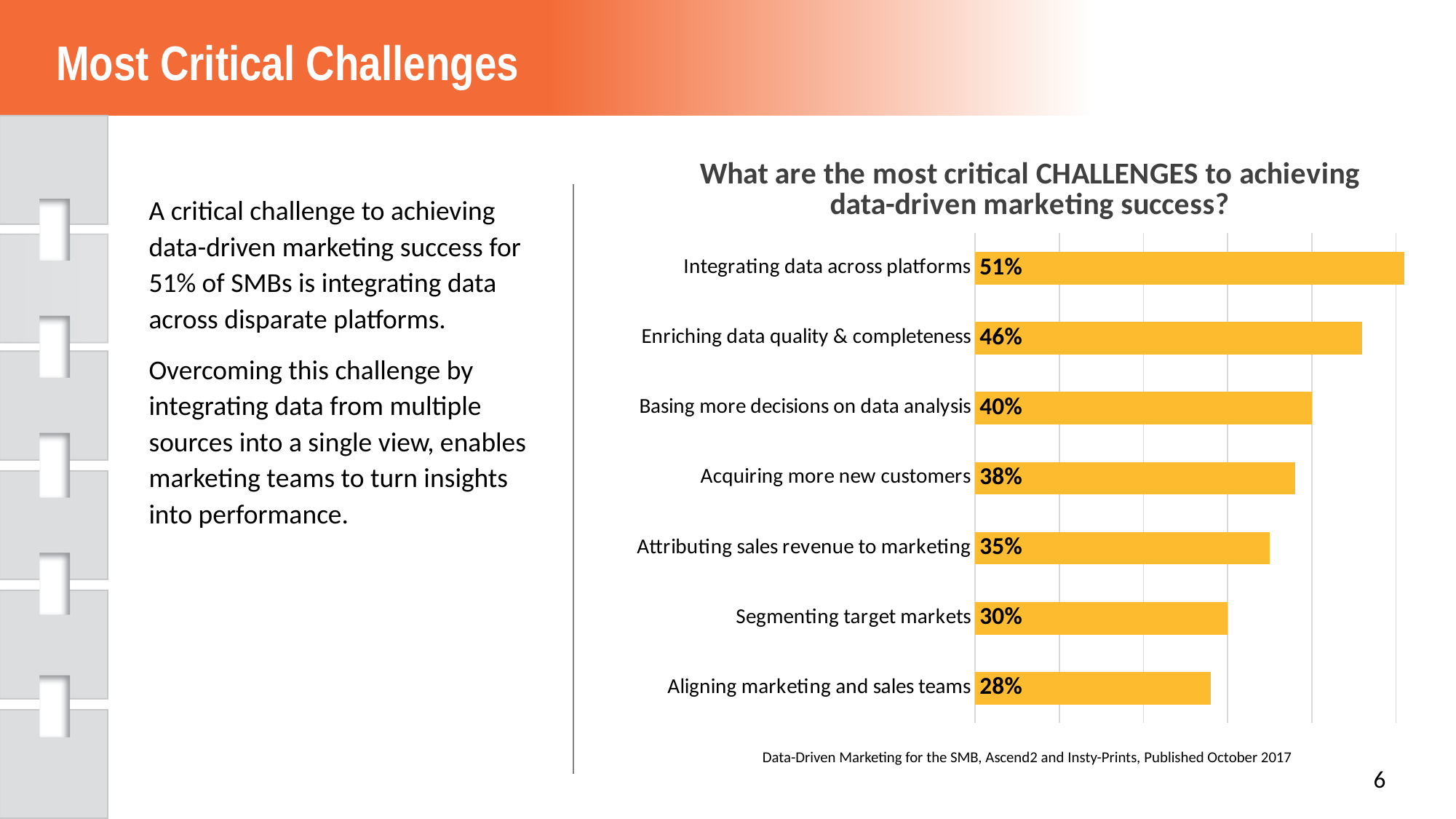
How many challenges are shown in the chart? 7 What is the difference in percentage points between Integrating data across platforms and Aligning marketing and sales teams? 23 What is the value for Attributing sales revenue to marketing? 35% Do the values increase or decrease from the top bar to the bottom bar? Decrease What is the title of the chart? What are the most critical CHALLENGES to achieving data-driven marketing success? What kind of chart is shown on the slide? Bar chart What percentage of respondents cited integrating data across platforms as a critical challenge? 51% Which is larger: the value for Acquiring more new customers or the value for Segmenting target markets? Acquiring more new customers What is the difference in percentage points between Enriching data quality & completeness and Basing more decisions on data analysis? 6 Which challenge has the highest percentage? Integrating data across platforms What is the value for Segmenting target markets? 30% Which challenge has the lowest percentage? Aligning marketing and sales teams